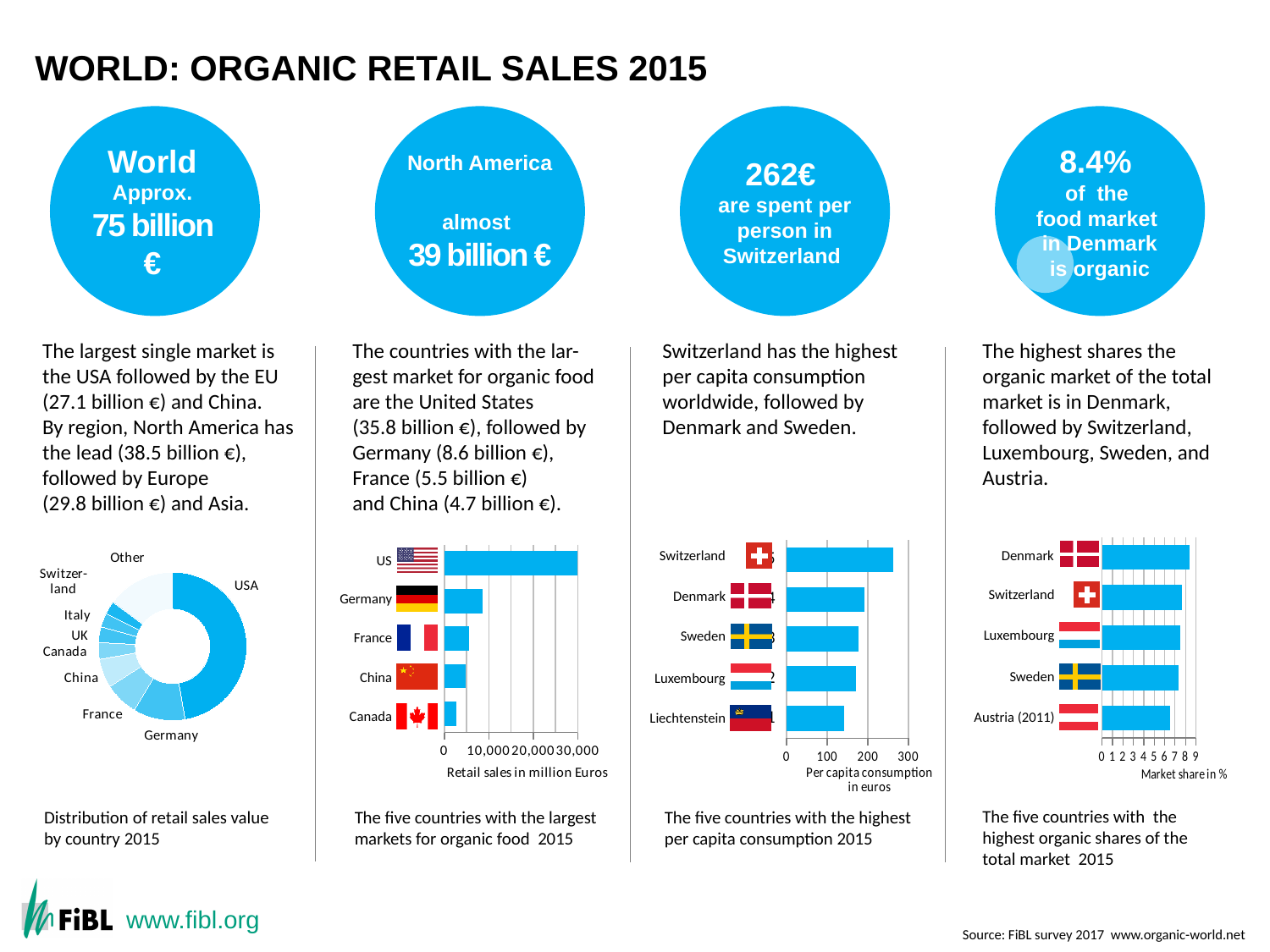
In the chart of the five countries with the highest per capita consumption, which country has the lowest per capita consumption? Liechtenstein What kind of chart is the 'Distribution of retail sales value by country 2015' chart on the left of the slide? Doughnut (pie) chart In the chart of the five countries with the highest per capita consumption, which country has the highest per capita consumption? Switzerland How many countries are shown in the chart of the five countries with the highest organic shares of the total market? 5 In the chart of the five countries with the largest markets for organic food, which country has the lowest retail sales? Canada In the chart of the five countries with the highest organic shares of the total market, which country has the highest market share? Denmark In the chart of the five countries with the largest markets for organic food, which has higher retail sales, Germany or France? Germany In the chart of the five countries with the largest markets for organic food, which country has the highest retail sales? US In the chart of the five countries with the largest markets for organic food, is the value for the US greater or less than 30,000? greater In the chart of the five countries with the highest per capita consumption, is the value for Sweden greater or less than 200? less In the chart of the five countries with the largest markets for organic food, is the value for Germany greater or less than 10,000? less